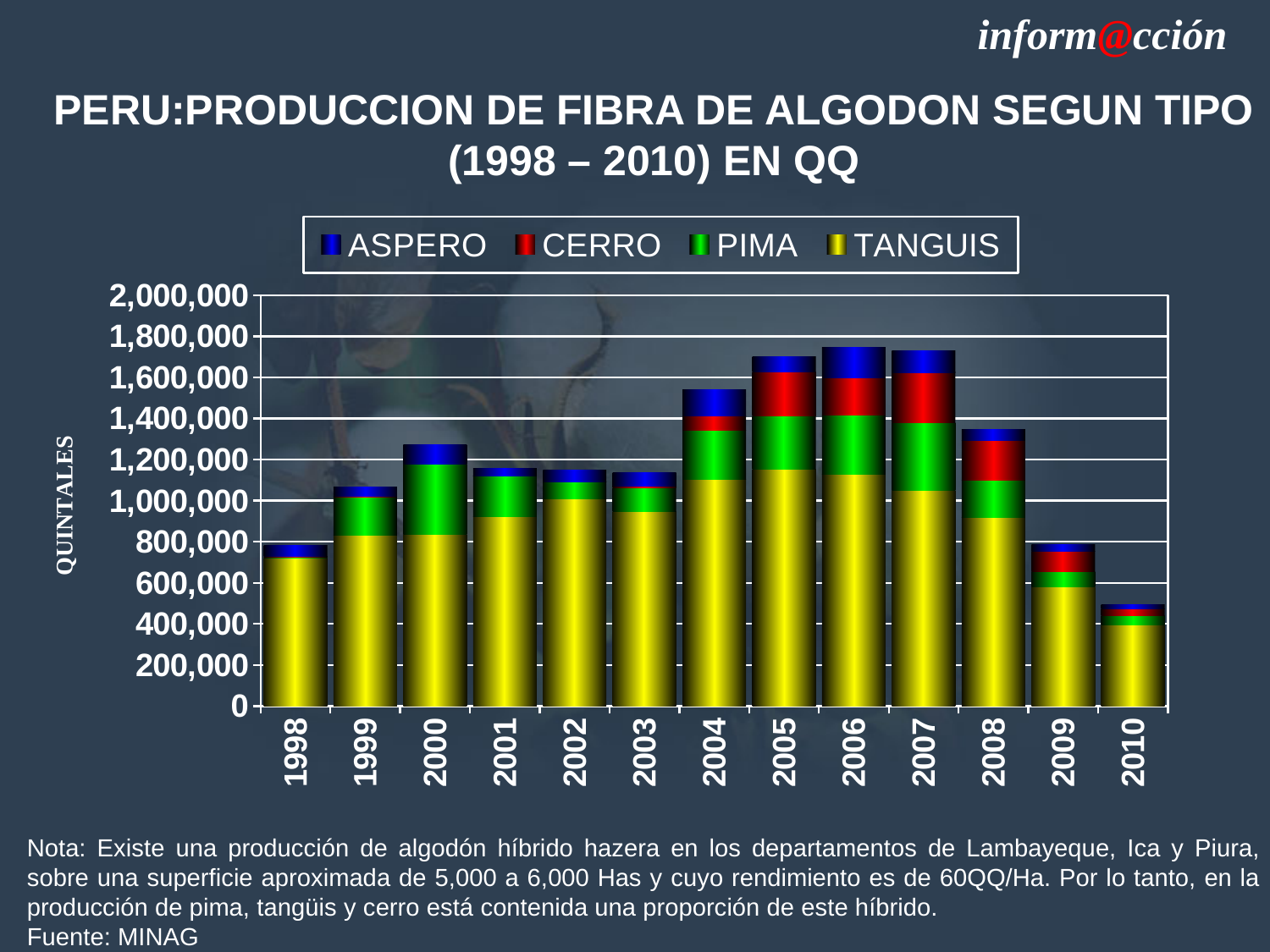
Which series is shown in yellow in the chart legend? TANGUIS Which year has the larger total production, 2005 or 2008? 2005 What is the label on the vertical axis of the chart? QUINTALES Is the total production for 2004 greater or less than 1,400,000? greater Is the total production for 2005 greater or less than 1,600,000? greater What kind of chart is shown on the slide? Stacked bar chart Is the total production for 2010 greater or less than 600,000? less How many years are shown on the x axis of the chart? 13 How many series does the chart legend list? 4 Which year has the lowest total cotton fibre production in the chart? 2010 Do the total production values rise or fall from 2007 to 2010? fall